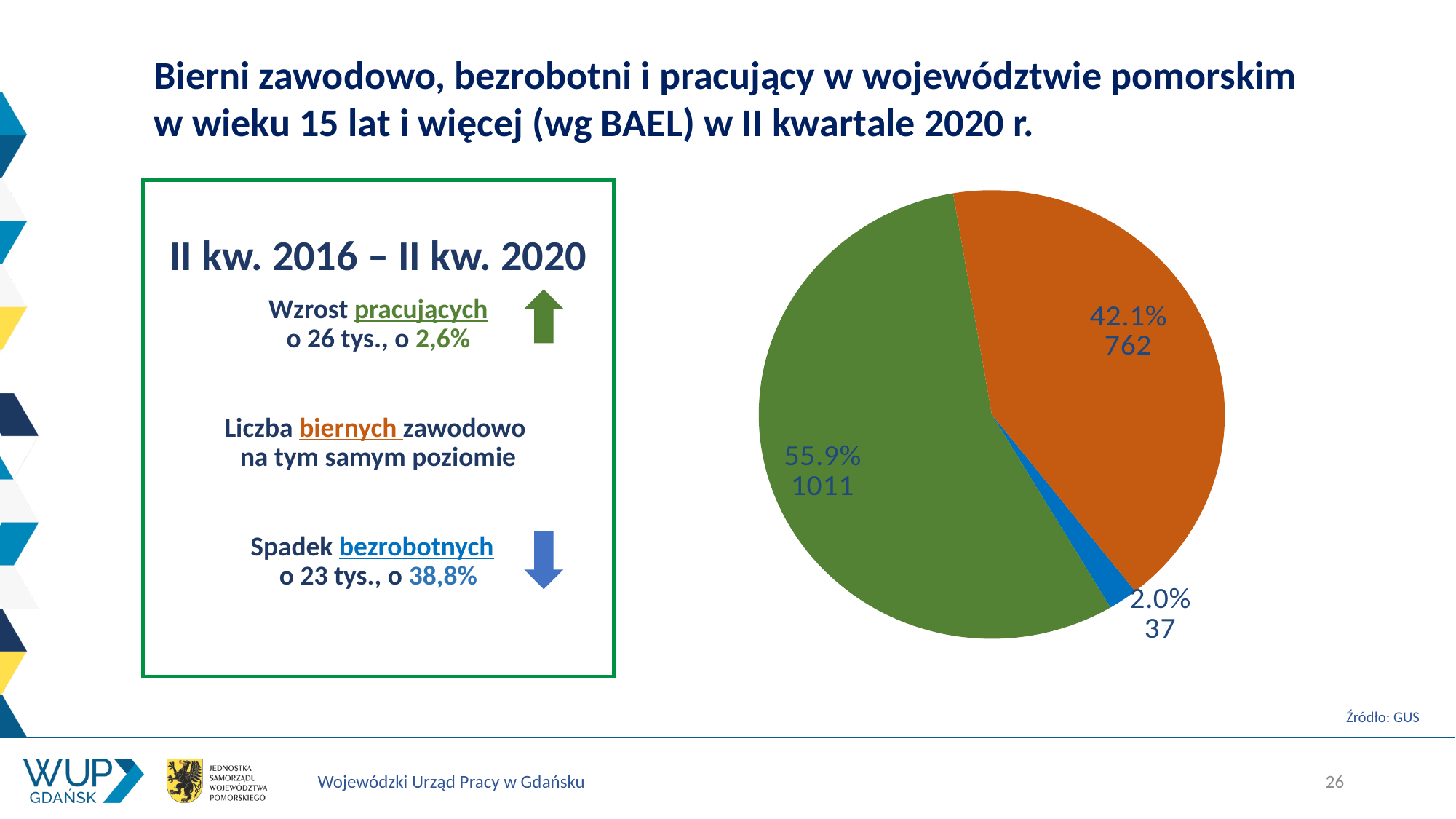
What kind of chart is shown on the slide? pie chart What is the difference between the values of the green slice and the orange slice in the pie chart? 249 Which is larger in the pie chart, the orange slice or the blue slice? the orange slice Which slice of the pie chart is the largest? the green slice (55.9%, 1011) What value is shown on the green slice of the pie chart? 1011 Which slice of the pie chart is the smallest? the blue slice (2.0%, 37) What value is shown on the blue slice of the pie chart? 37 How many slices does the pie chart have? 3 What is the total of the three values shown on the pie chart? 1810 What percentage share is shown on the green slice of the pie chart? 55.9% What percentage share is shown on the orange slice of the pie chart? 42.1% What percentage share is shown on the blue slice of the pie chart? 2.0%